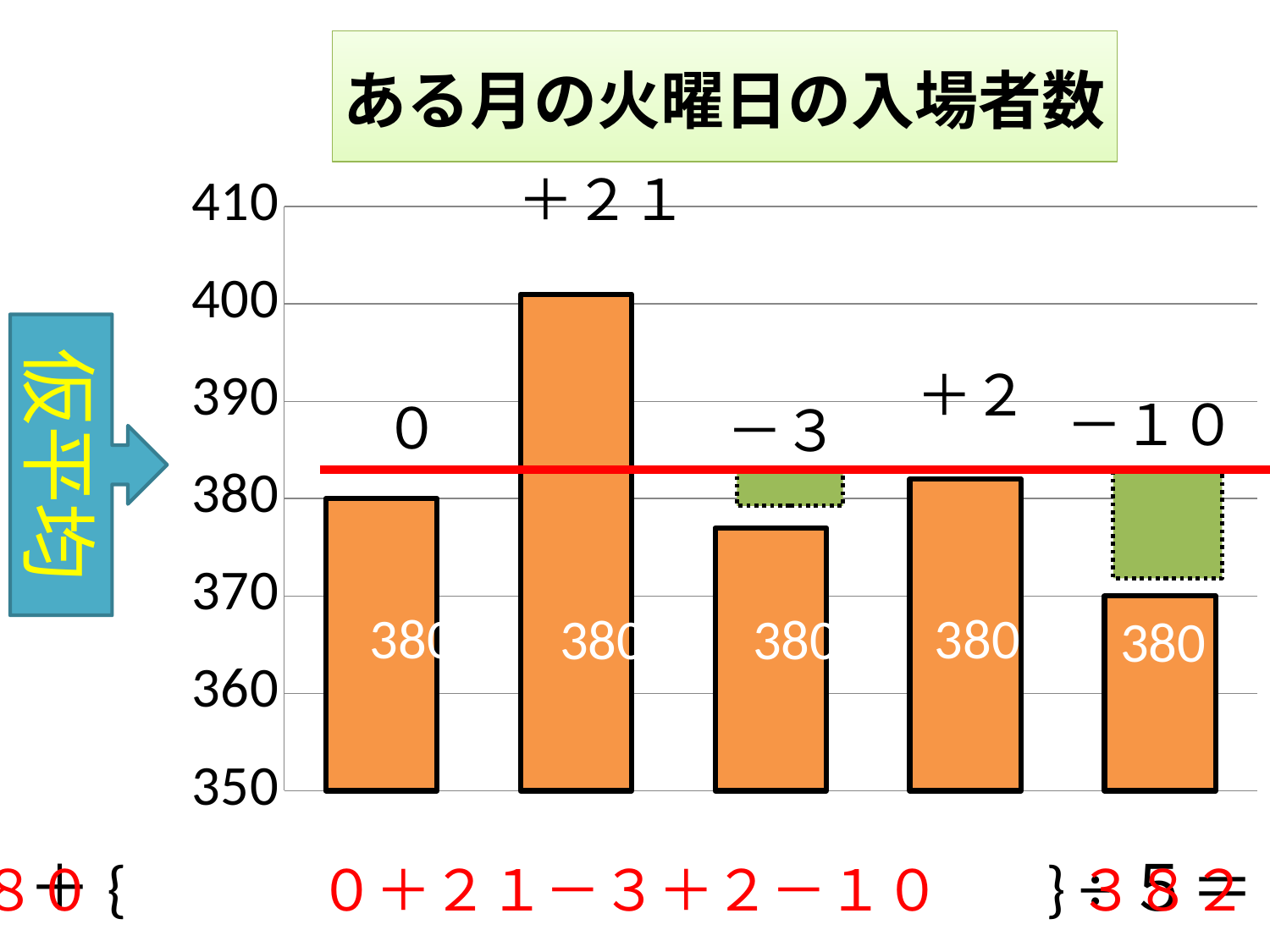
What deviation label is printed above the third bar from the left? －３ What deviation label is printed above the second bar from the left? ＋２１ Which bar is the shortest in the chart? the fifth (rightmost) bar Which is taller, the second bar from the left or the fourth bar from the left? the second bar from the left Is the value of the rightmost bar greater or less than 380? less Is the value of the second bar from the left greater or less than 390? greater What value is printed inside each bar as the provisional average (仮平均)? 380 What kind of chart is shown on the slide? bar chart Which bar is the tallest in the chart? the second bar from the left What is the title of the chart? ある月の火曜日の入場者数 How many bars are plotted in the chart? 5 What deviation label is printed above the rightmost bar? －１０